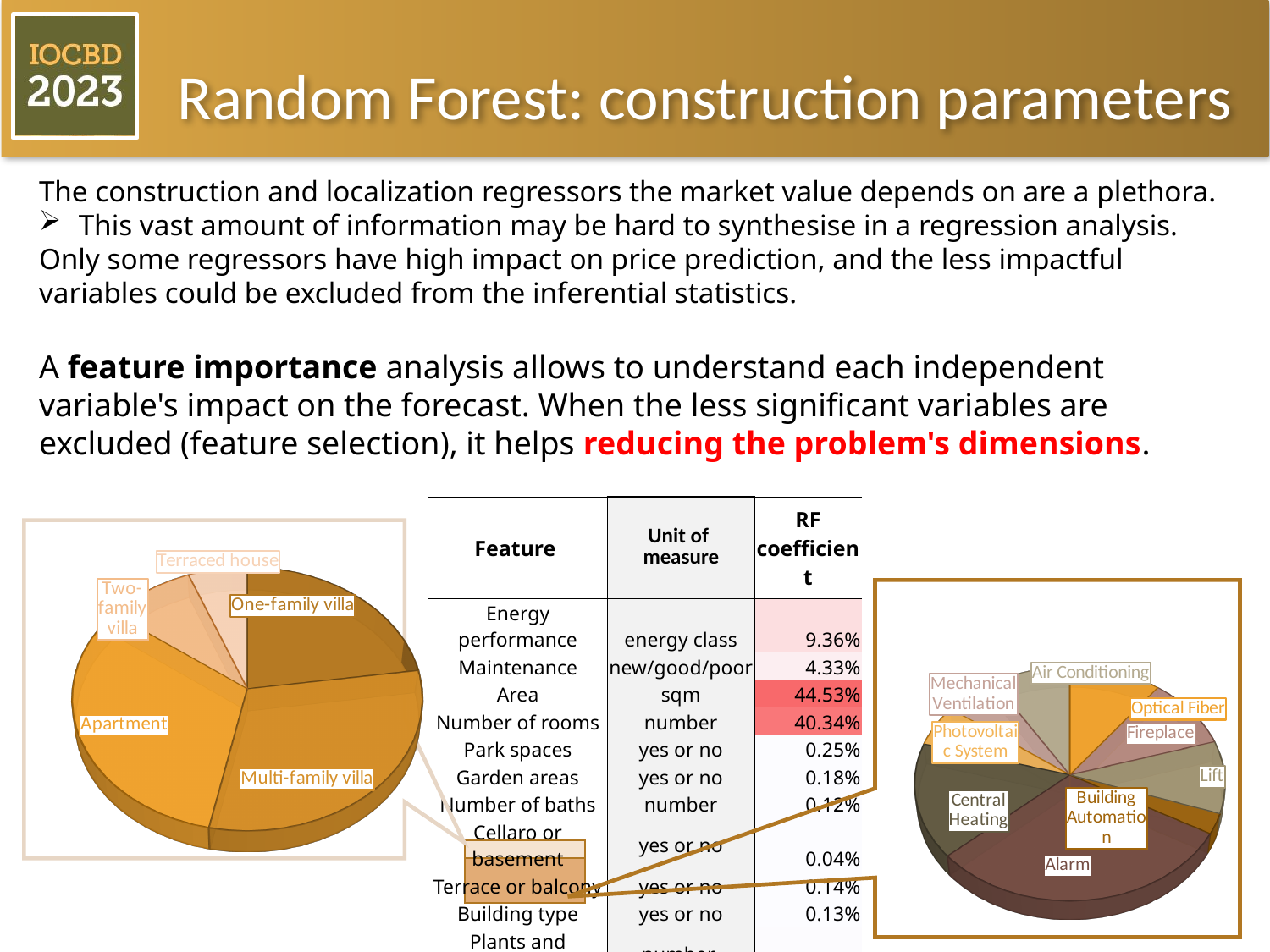
In the pie chart on the right of the slide, which slice is larger, Alarm or Lift? Alarm In the pie chart on the left of the slide, which slice is larger, Apartment or Terraced house? Apartment Which building-type categories are labelled in the pie chart on the left of the slide? Terraced house, Two-family villa, One-family villa, Apartment, Multi-family villa What kind of chart is the chart on the right of the slide? pie chart Is Photovoltaic System one of the categories labelled in the pie chart on the right of the slide? Yes In the pie chart on the right of the slide, which category has the largest slice? Alarm In the pie chart on the left of the slide, which slice is larger, Multi-family villa or Two-family villa? Multi-family villa How many categories are shown in the pie chart on the right of the slide? 9 What kind of chart is the chart on the left of the slide? pie chart How many categories are shown in the pie chart on the left of the slide? 5